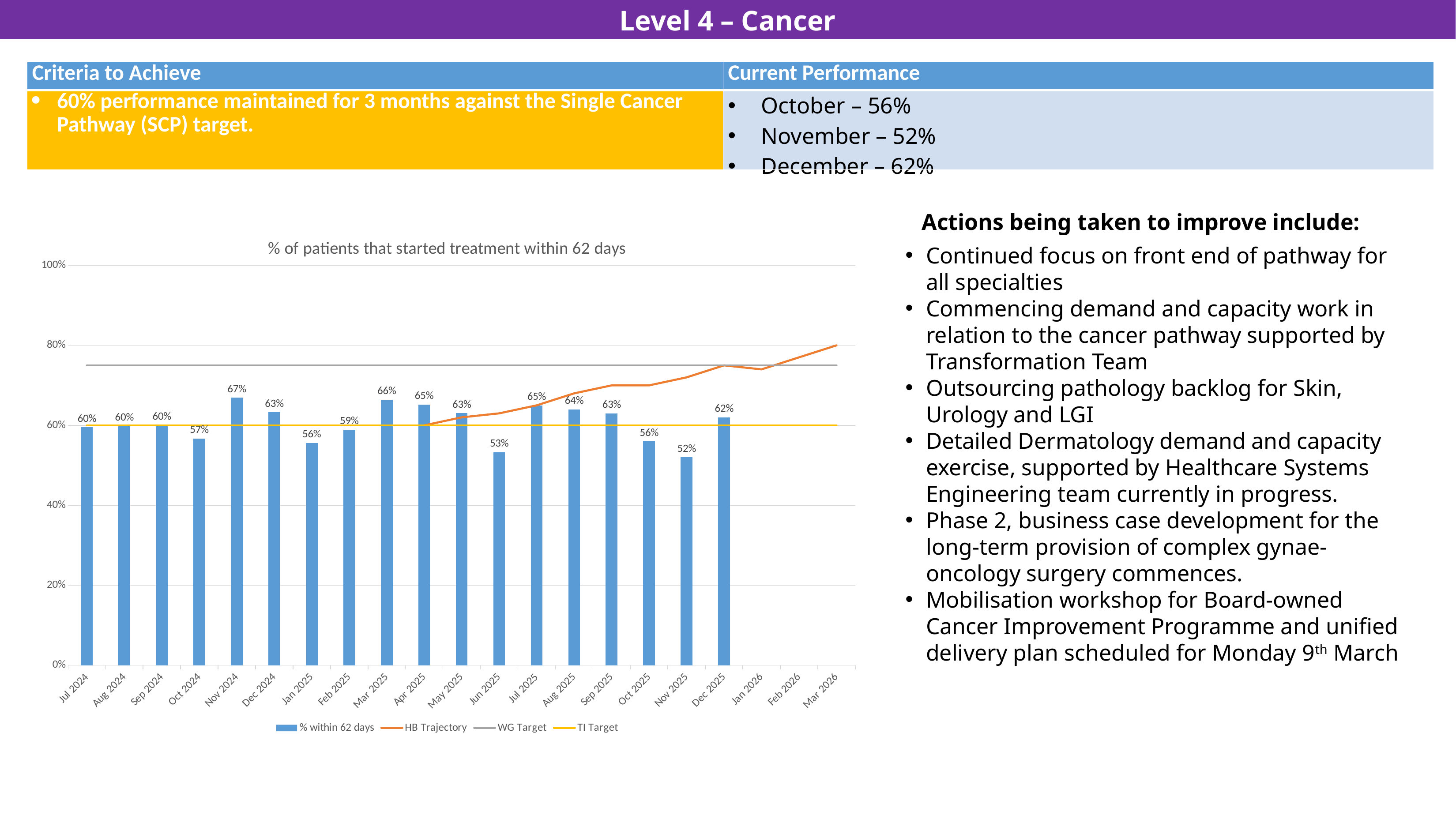
How many months have a '% within 62 days' bar plotted in the chart? 18 Is the WG Target line in the chart greater or less than 60%? greater What kind of chart is used to show the '% within 62 days' values? Bar chart Is the HB Trajectory value at Mar 2026 greater or less than 60%? greater Which month has the highest '% within 62 days' value in the chart? Nov 2024 Which month has the lowest '% within 62 days' value in the chart? Nov 2025 How many series does the chart's legend list? 4 Do the '% within 62 days' values rise or fall from Sep 2025 to Nov 2025? Fall Which is larger in the chart, the value for Jun 2025 or the value for Oct 2025? Oct 2025 What is the value for Mar 2025 in the chart? 66% What is the value for Nov 2025 in the '% of patients that started treatment within 62 days' chart? 52% What is the difference between the values for Nov 2024 and Nov 2025 in the chart? 15 percentage points